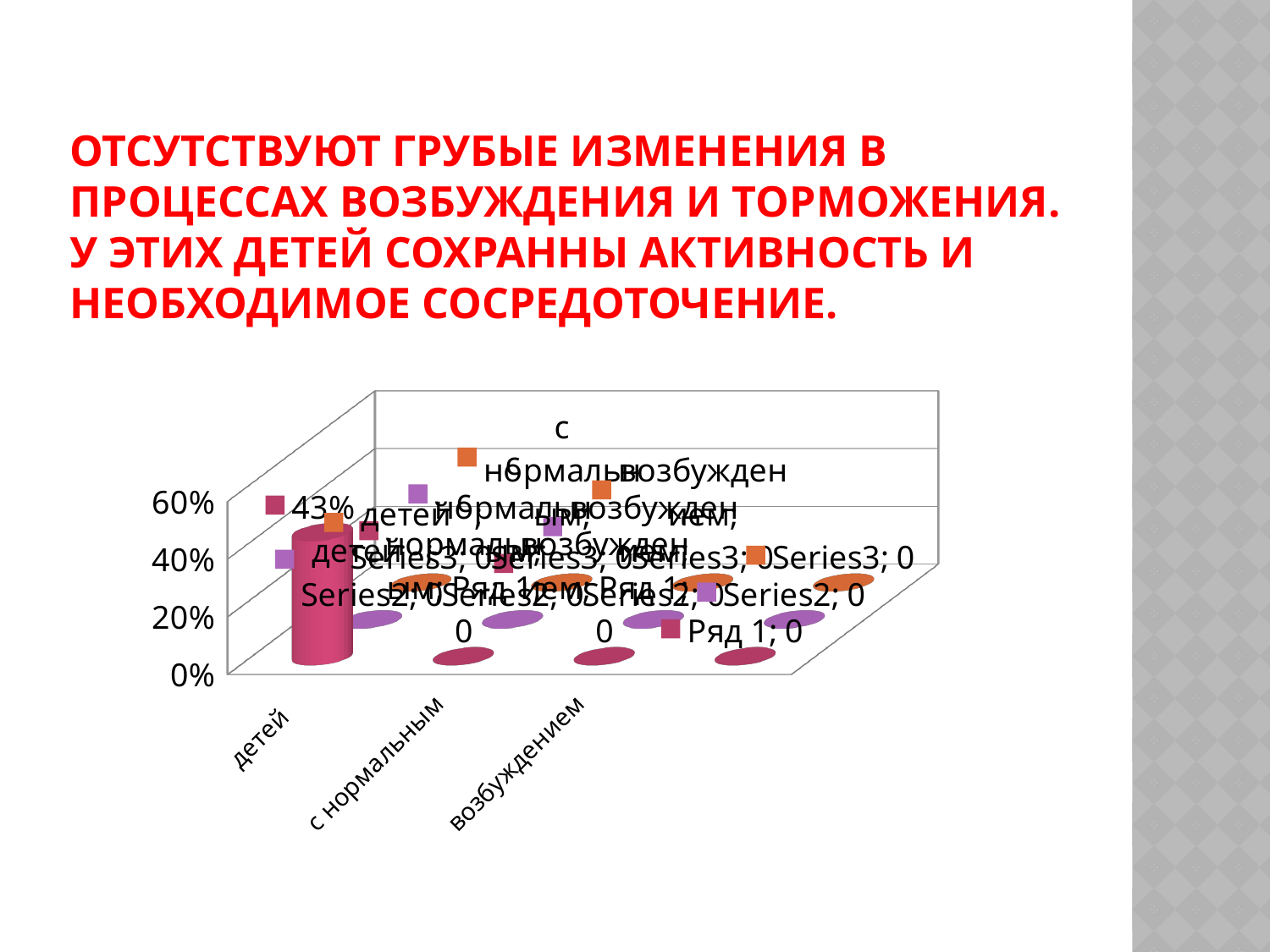
Is the value for "детей" greater or less than 60%? less How many categories are labelled on the horizontal axis? 3 What is the lowest tick value shown on the vertical axis? 0% Which category has the highest value? детей What value is shown for the category "детей"? 43% What is the highest tick value shown on the vertical axis? 60% Is the value for "детей" greater or less than 40%? greater What kind of chart is shown on the slide? bar chart